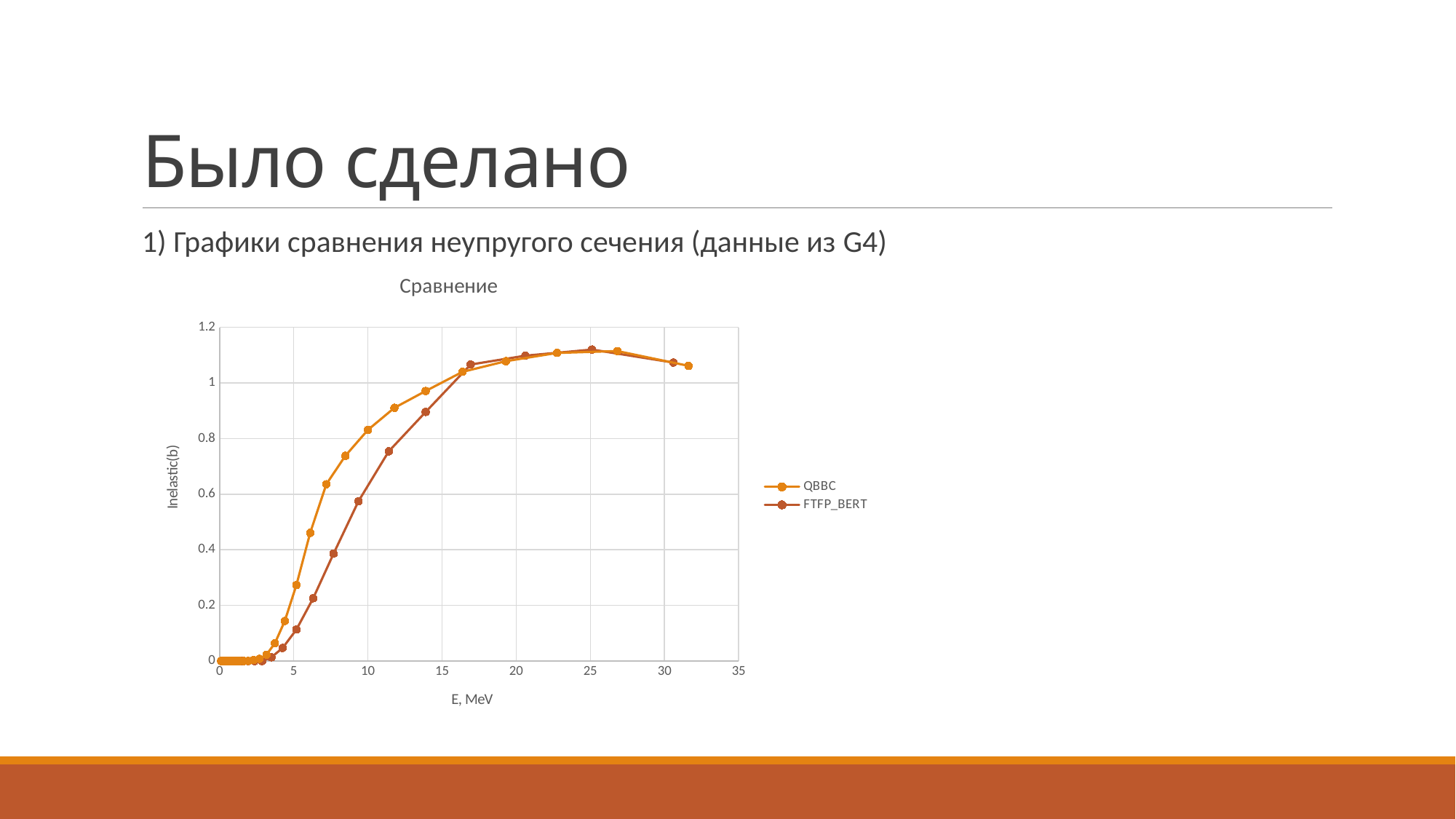
Do the values of the QBBC series rise or fall as E increases from 0 to 20 MeV? rise Is the maximum value of the QBBC series greater or less than 1? greater How many series does the legend list? 2 Is the value for FTFP_BERT at E = 10 MeV greater or less than 0.8? less What kind of chart is shown on the slide? line chart Is the maximum value of the FTFP_BERT series greater or less than 1.2? less What is the title of the chart? Сравнение At E = 10 MeV, which series has the higher value, QBBC or FTFP_BERT? QBBC What is the label of the x axis? E, MeV